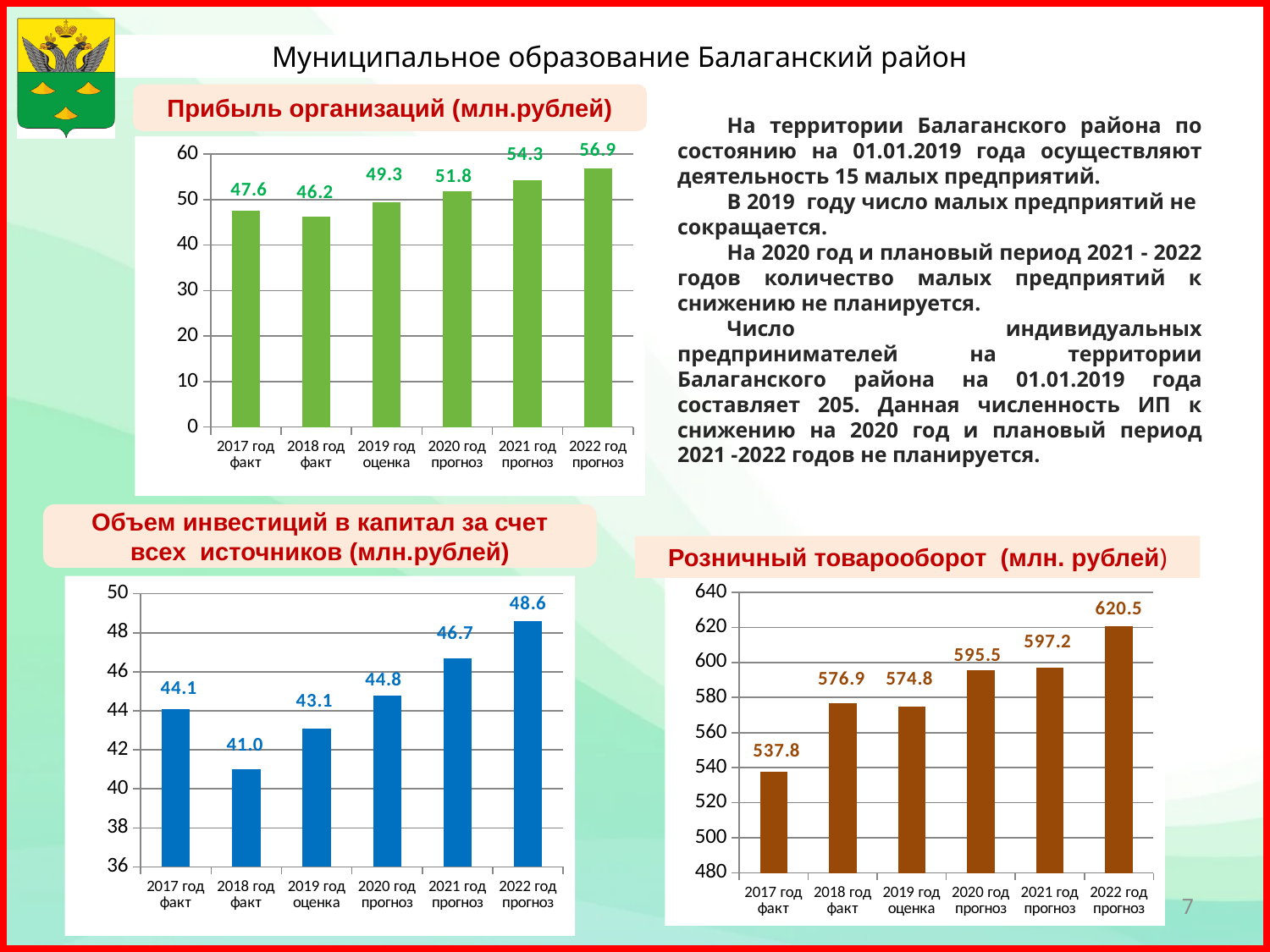
In the chart 'Прибыль организаций (млн.рублей)', which category has the lowest value? 2018 год факт In the chart 'Розничный товарооборот (млн. рублей)', what is the value for 2020 год прогноз? 595.5 In the chart 'Прибыль организаций (млн.рублей)', what is the value for 2019 год оценка? 49.3 In the chart 'Прибыль организаций (млн.рублей)', how many bars are plotted? 6 In the chart 'Прибыль организаций (млн.рублей)', what is the difference between the 2022 год прогноз value and the 2017 год факт value? 9.3 In the chart 'Розничный товарооборот (млн. рублей)', what is the difference between the 2022 год прогноз value and the 2021 год прогноз value? 23.3 In the chart 'Объем инвестиций в капитал за счет всех источников (млн.рублей)', what is the value for 2018 год факт? 41.0 In the chart 'Объем инвестиций в капитал за счет всех источников (млн.рублей)', which category has the highest value? 2022 год прогноз In the chart 'Розничный товарооборот (млн. рублей)', do the values generally rise or fall from 2017 год факт to 2022 год прогноз? rise In the chart 'Розничный товарооборот (млн. рублей)', is the value for 2017 год факт greater or less than 560? less What type of chart is 'Объем инвестиций в капитал за счет всех источников (млн.рублей)'? Bar chart In the chart 'Объем инвестиций в капитал за счет всех источников (млн.рублей)', which is larger: the value for 2017 год факт or the value for 2019 год оценка? 2017 год факт